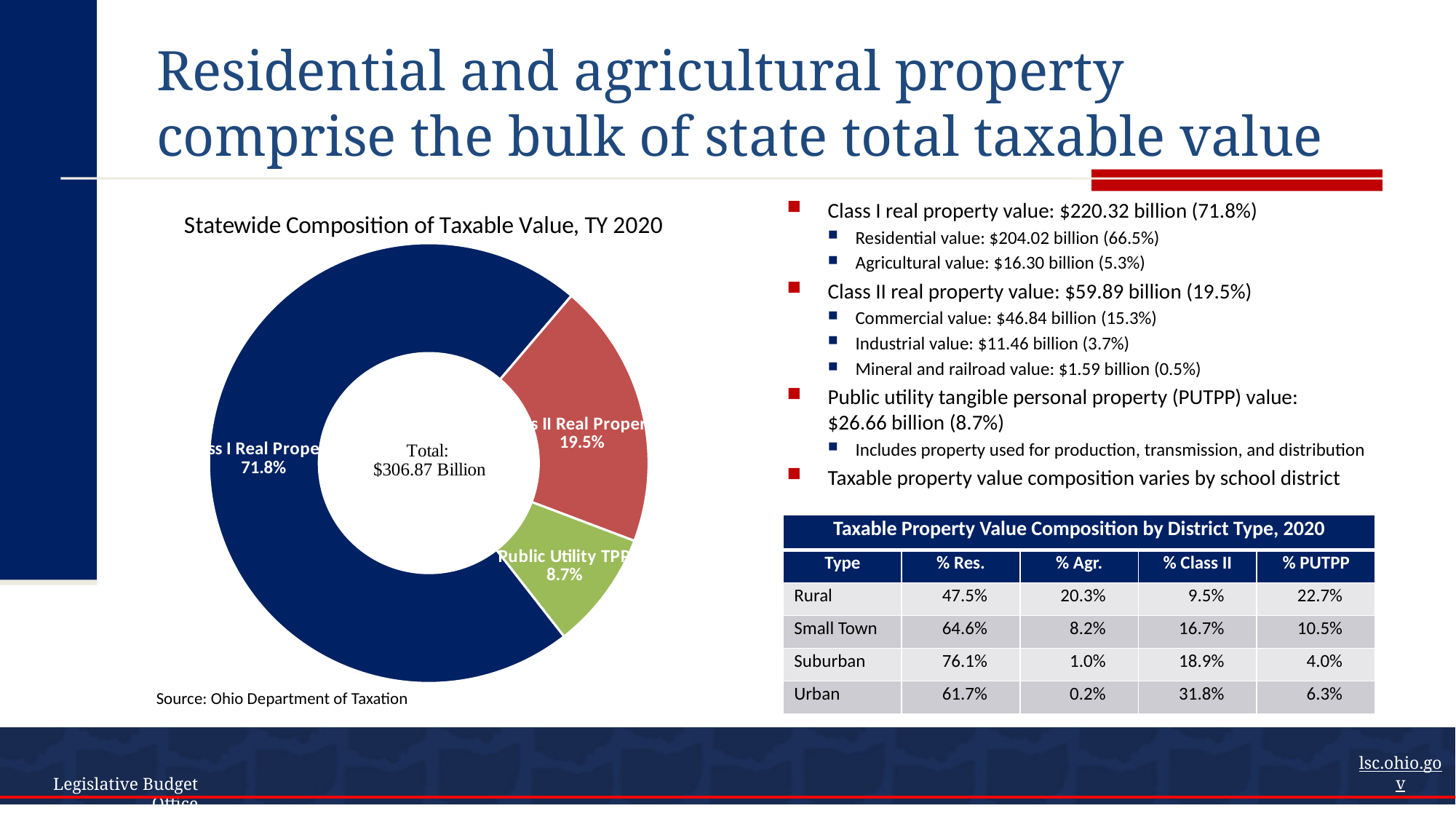
Which category has the largest slice in the chart? Class I Real Property What is the difference in percentage points between the Class II Real Property and Public Utility TPP slices? 10.8 What total value is printed in the center of the chart? $306.87 Billion What is the title of the chart? Statewide Composition of Taxable Value, TY 2020 What is the difference in percentage points between the Class I Real Property and Class II Real Property slices? 52.3 What percentage is shown for Public Utility TPP in the chart? 8.7% What share of the doughnut chart does Class II Real Property represent? 19.5% What share of the doughnut chart does Class I Real Property represent? 71.8% What kind of chart is shown on the slide? Doughnut chart Which category has the smallest slice in the chart? Public Utility TPP Which slice is larger, Class II Real Property or Public Utility TPP? Class II Real Property How many slices does the chart have? 3